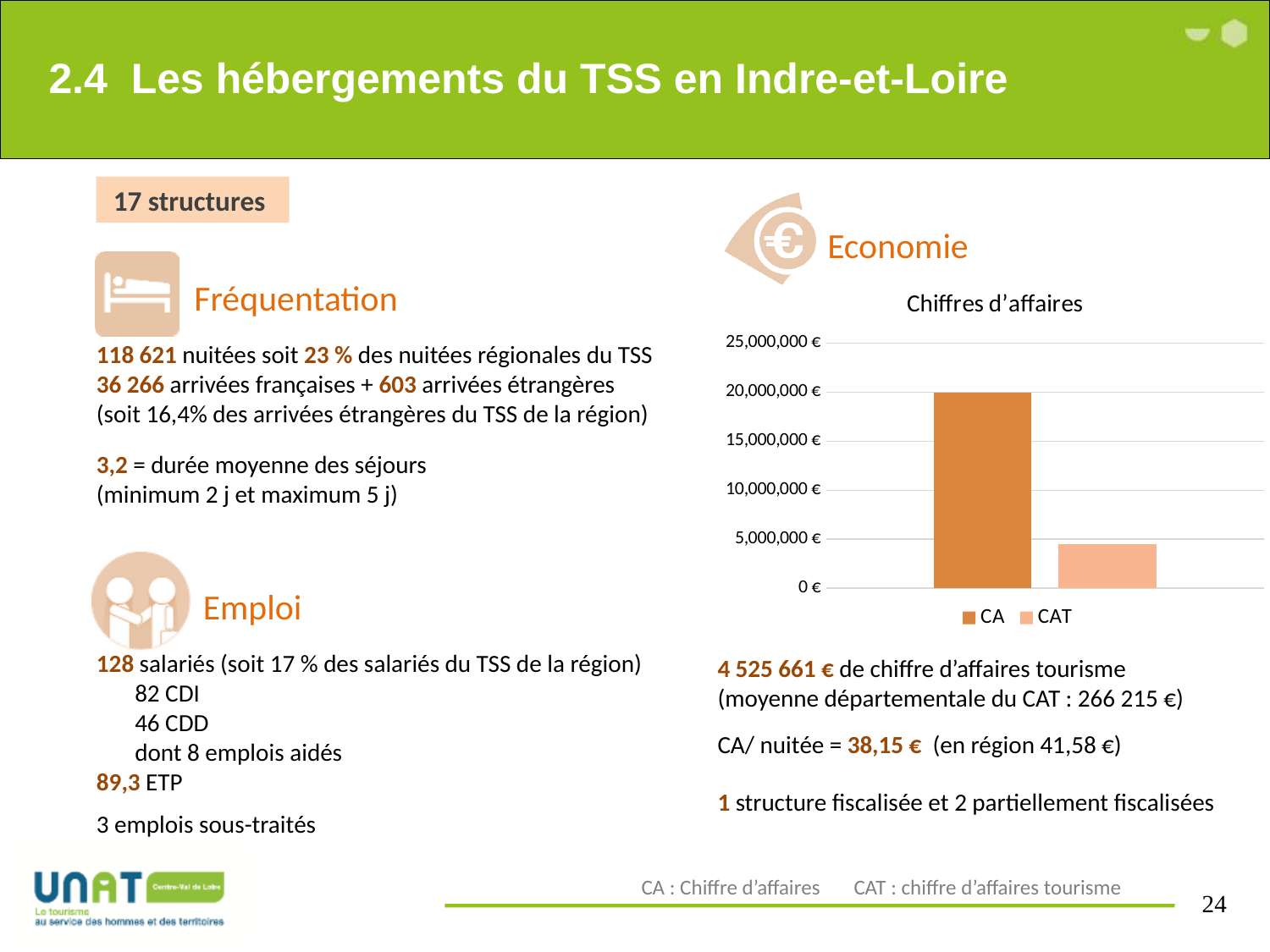
Which series has the taller bar in the "Chiffres d'affaires" chart? CA How many series does the legend of the "Chiffres d'affaires" chart list? 2 In the "Chiffres d'affaires" chart, is the value for CAT greater or less than 5,000,000 €? less How many bars are plotted in the "Chiffres d'affaires" chart? 2 What kind of chart is shown under "Chiffres d'affaires"? bar chart In the "Chiffres d'affaires" chart, is the value for CA greater or less than 15,000,000 €? greater What are the two legend entries of the "Chiffres d'affaires" chart? CA and CAT Which series has the shorter bar in the "Chiffres d'affaires" chart? CAT What is the highest tick value shown on the vertical axis of the "Chiffres d'affaires" chart? 25,000,000 € What is the title of the chart on the slide? Chiffres d'affaires In the "Chiffres d'affaires" chart, is the value for CA greater or less than 25,000,000 €? less In the "Chiffres d'affaires" chart, is the CA bar larger or smaller than the CAT bar? larger